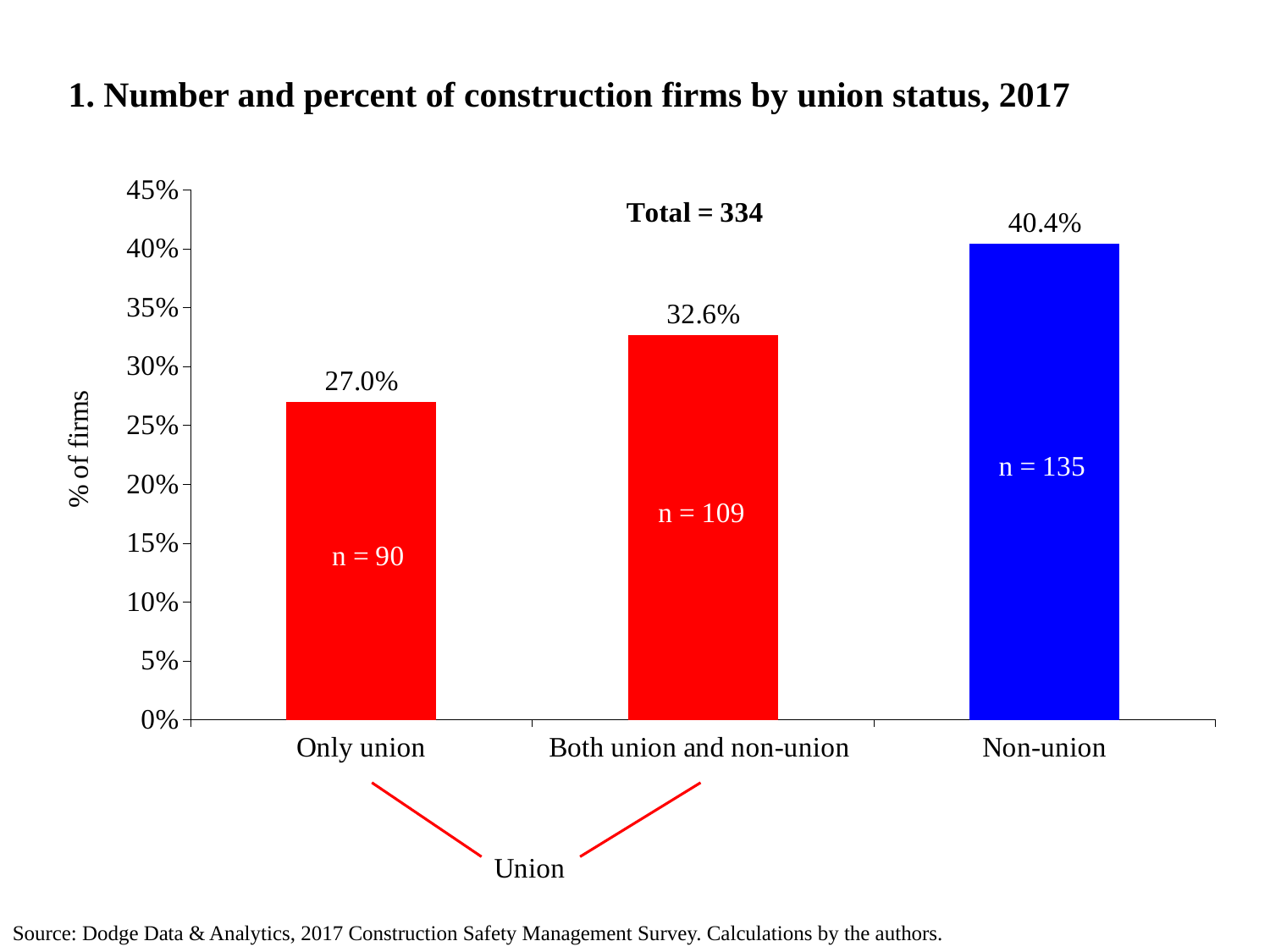
What percentage of firms are 'Non-union'? 40.4% Which union status category has the highest percentage of firms? Non-union What kind of chart is shown on the slide? Bar chart What percentage of firms are 'Both union and non-union'? 32.6% What percentage of firms are 'Only union'? 27.0% How many firms (n) are in the 'Only union' category? n = 90 What is the difference in percentage points between 'Non-union' and 'Only union' firms? 13.4 What total number of firms is stated on the chart? Total = 334 How many categories are shown on the x axis? 3 How many firms (n) are in the 'Non-union' category? n = 135 Which is larger: the percentage for 'Both union and non-union' or for 'Only union'? Both union and non-union Which union status category has the lowest percentage of firms? Only union